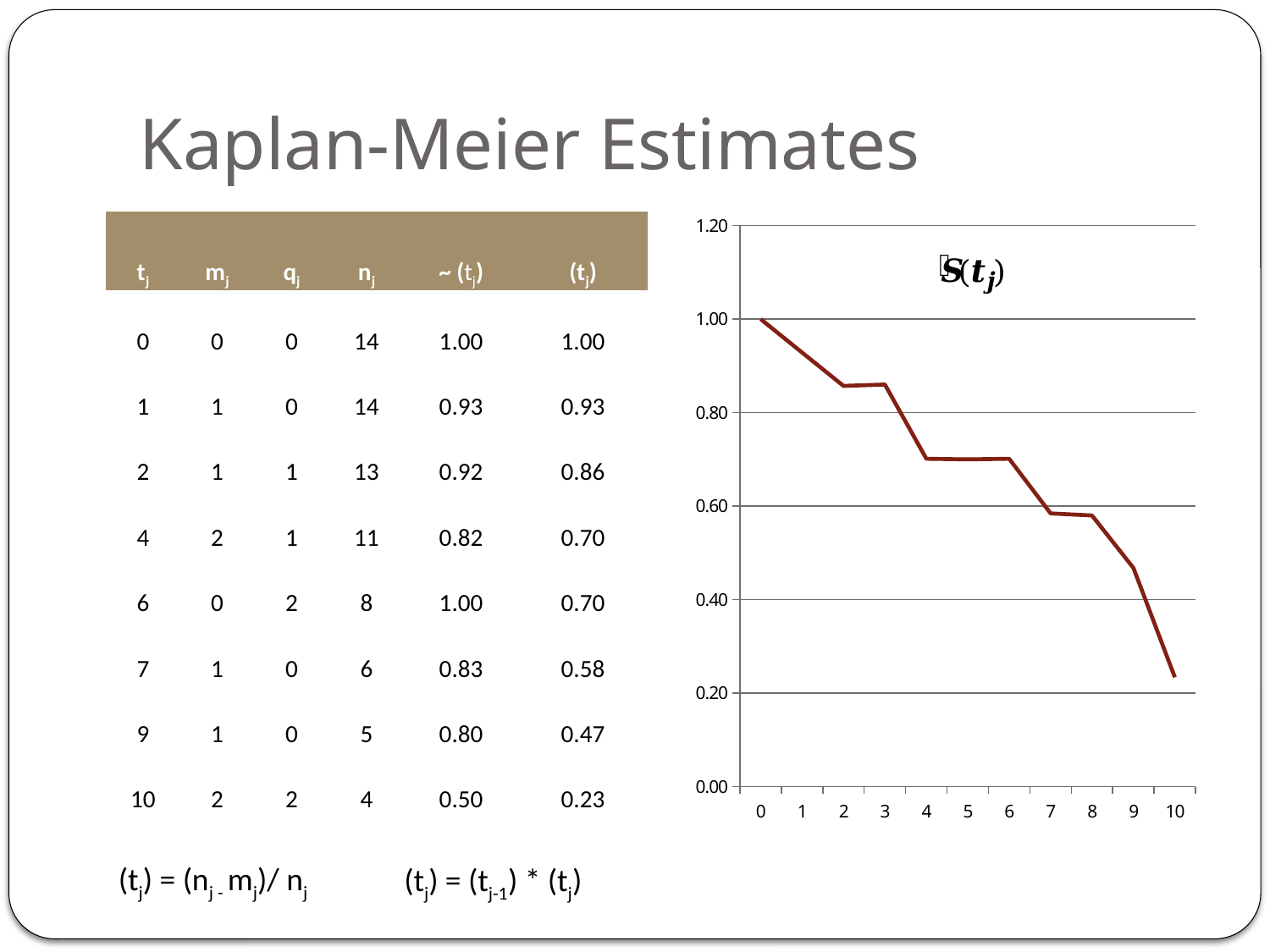
In the S(t_j) chart, is the value at t = 4 greater or less than 0.60? greater What kind of chart is shown on the right of the slide? line chart In the S(t_j) chart, is the value at t = 10 greater or less than 0.40? less In the S(t_j) chart, is the value at t = 2 greater or less than 0.80? greater In the S(t_j) chart, which has the larger value: t = 4 or t = 8? t = 4 In the S(t_j) chart, do the values rise or fall as t increases from 0 to 10? fall How many tick labels are shown on the x axis of the S(t_j) chart? 11 What is the highest value labelled on the y axis of the S(t_j) chart? 1.20 In the S(t_j) chart, at which value of t is the plotted value highest? 0 In the S(t_j) chart, what is the plotted value at t = 0? 1.00 In the S(t_j) chart, at which value of t is the plotted value lowest? 10